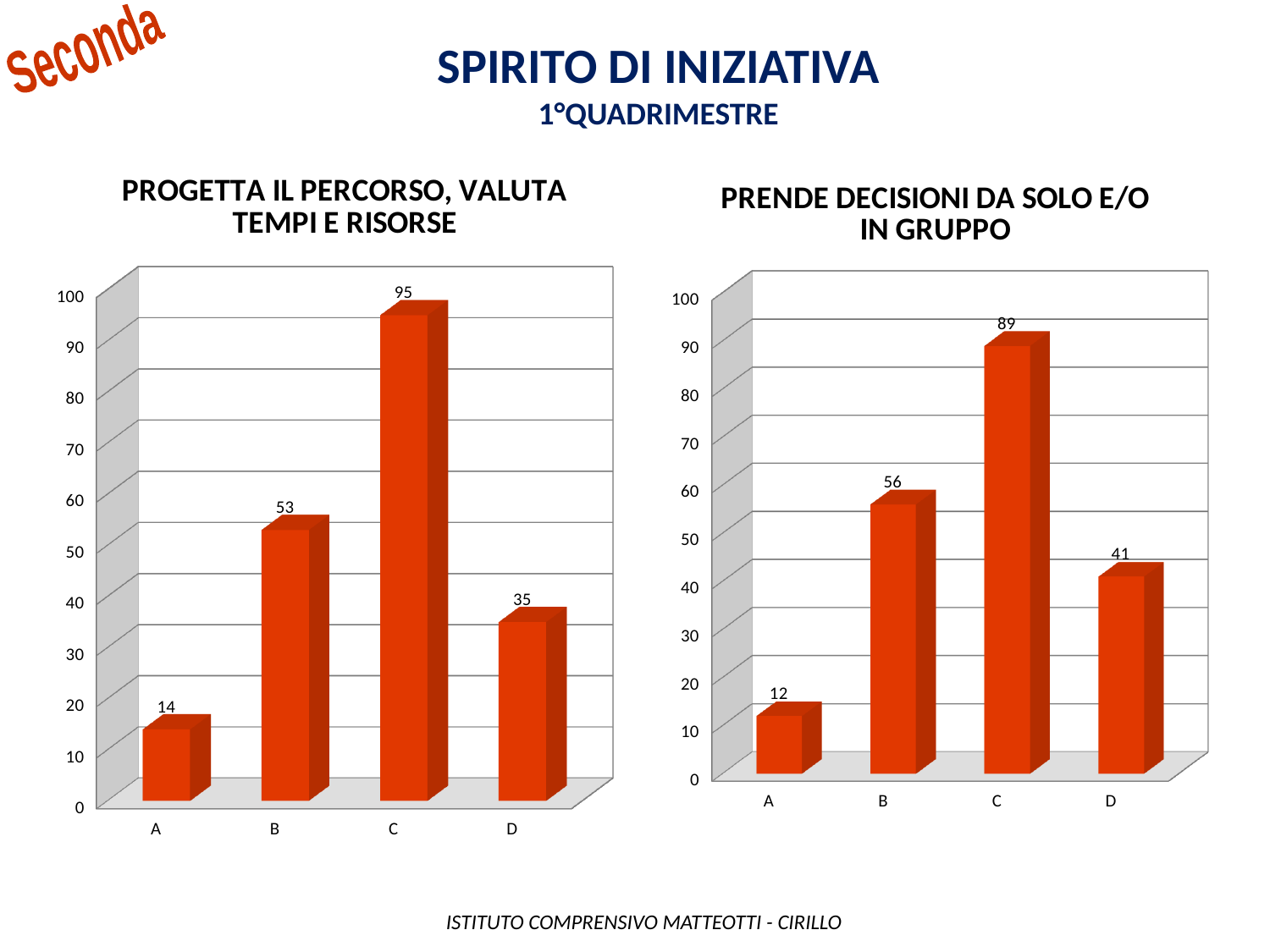
In the chart titled "PROGETTA IL PERCORSO, VALUTA TEMPI E RISORSE", is the value for D greater or less than 40? less In the chart titled "PROGETTA IL PERCORSO, VALUTA TEMPI E RISORSE", what is the difference between the values for C and B? 42 What is the title of the chart on the right side of the slide? PRENDE DECISIONI DA SOLO E/O IN GRUPPO In the chart titled "PROGETTA IL PERCORSO, VALUTA TEMPI E RISORSE", what is the value for category C? 95 In the chart titled "PRENDE DECISIONI DA SOLO E/O IN GRUPPO", which category has the highest value? C How many categories are shown in the chart titled "PRENDE DECISIONI DA SOLO E/O IN GRUPPO"? 4 What kind of chart is the chart titled "PROGETTA IL PERCORSO, VALUTA TEMPI E RISORSE"? Bar chart In the chart titled "PROGETTA IL PERCORSO, VALUTA TEMPI E RISORSE", which category has the lowest value? A In the chart titled "PRENDE DECISIONI DA SOLO E/O IN GRUPPO", what is the value for category B? 56 In the chart titled "PROGETTA IL PERCORSO, VALUTA TEMPI E RISORSE", what is the value for category A? 14 In the chart titled "PRENDE DECISIONI DA SOLO E/O IN GRUPPO", what is the difference between the values for D and A? 29 In the chart titled "PRENDE DECISIONI DA SOLO E/O IN GRUPPO", which is larger, the value for B or the value for D? B